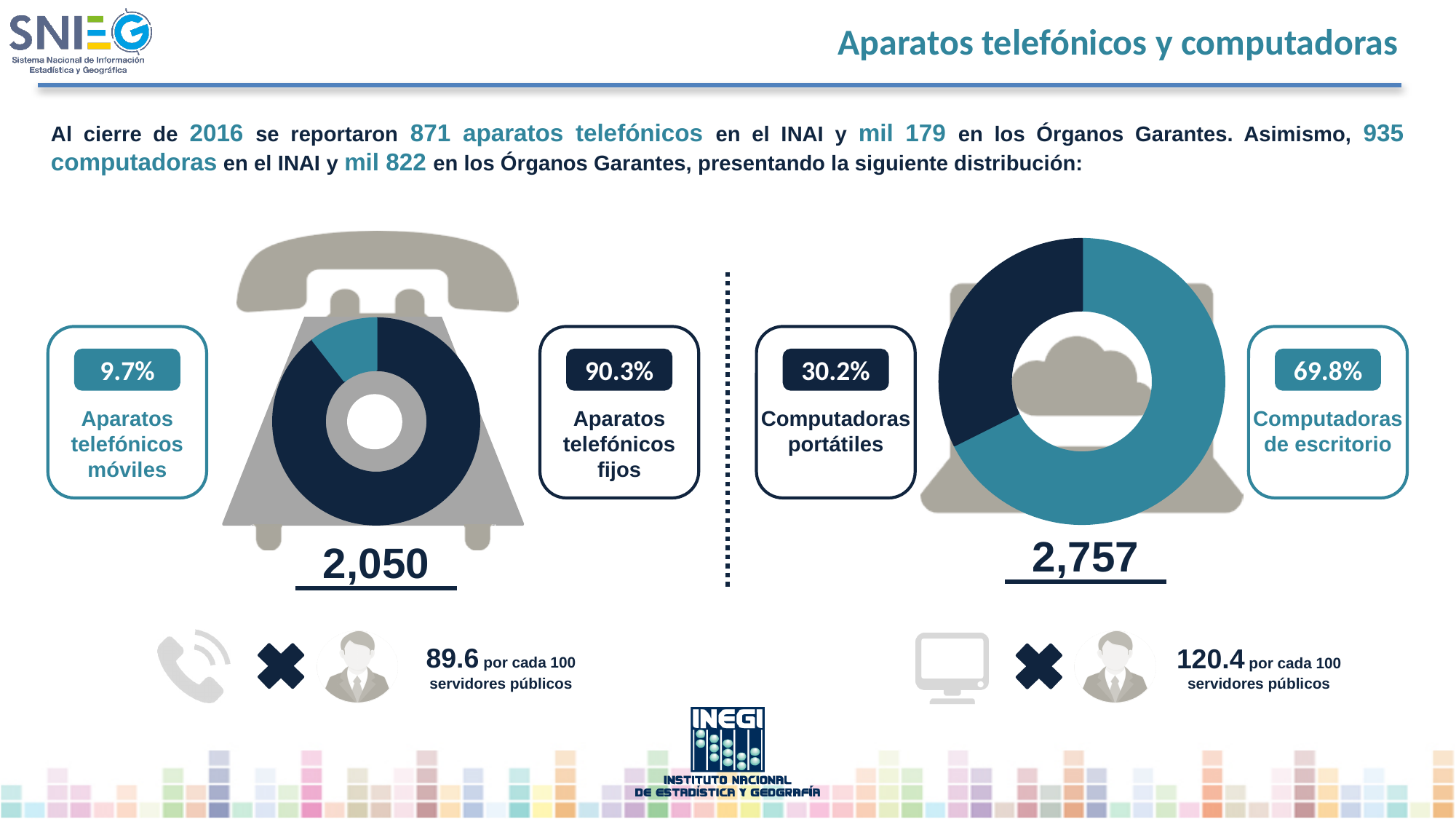
How many categories does the right chart (computadoras) show? 2 On the right chart (computadoras), which category has the smaller share? Computadoras portátiles Which is larger: the share of Aparatos telefónicos móviles on the left chart or the share of Computadoras portátiles on the right chart? Computadoras portátiles What total is printed below the right chart (computadoras)? 2,757 On the right chart (computadoras), what is the difference in percentage points between Computadoras de escritorio and Computadoras portátiles? 39.6 On the left chart (aparatos telefónicos), which category has the larger share? Aparatos telefónicos fijos What kind of chart is used on the left side of the slide for aparatos telefónicos? Donut (pie) chart On the left chart (aparatos telefónicos), what share is shown for Aparatos telefónicos fijos? 90.3% On the left chart (aparatos telefónicos), what share is shown for Aparatos telefónicos móviles? 9.7% On the right chart (computadoras), what share is shown for Computadoras portátiles? 30.2% What total is printed below the left chart (aparatos telefónicos)? 2,050